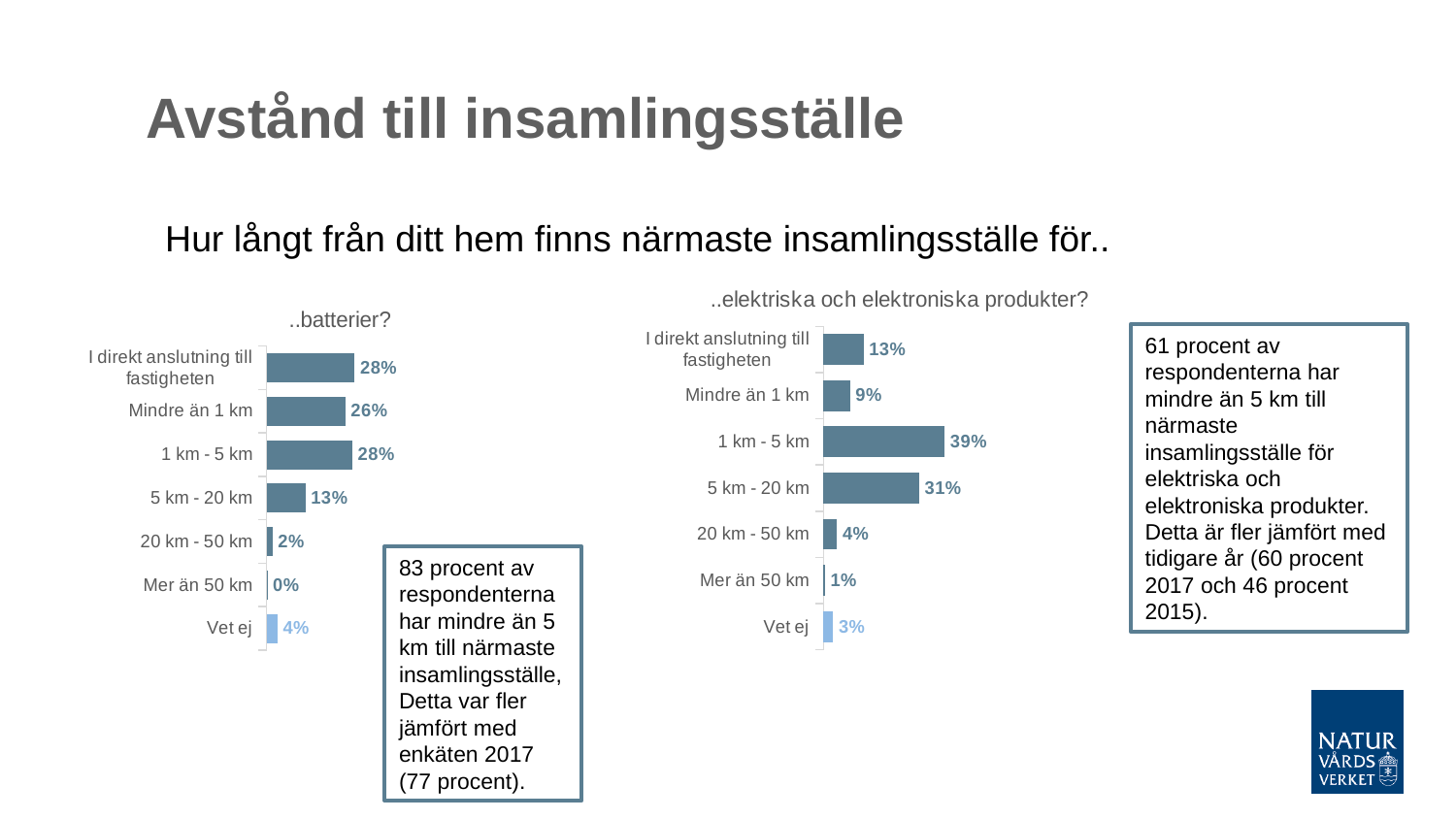
In the '..batterier?' chart, what is the value for 'Vet ej'? 4% In the '..batterier?' chart, what is the value for 'Mindre än 1 km'? 26% In the '..elektriska och elektroniska produkter?' chart, what is the value for '1 km - 5 km'? 39% In the '..batterier?' chart, what is the value for '5 km - 20 km'? 13% In the '..batterier?' chart, which is larger: 'Mindre än 1 km' or '5 km - 20 km'? Mindre än 1 km In the '..elektriska och elektroniska produkter?' chart, which category has the highest value? 1 km - 5 km In the '..elektriska och elektroniska produkter?' chart, what is the difference between '1 km - 5 km' and '5 km - 20 km'? 8% In the '..elektriska och elektroniska produkter?' chart, what is the value for 'I direkt anslutning till fastigheten'? 13% In the '..batterier?' chart, which category has the lowest value? Mer än 50 km What kind of chart is the '..elektriska och elektroniska produkter?' chart? Bar chart How many categories does the '..batterier?' chart show? 7 In the '..elektriska och elektroniska produkter?' chart, what is the value for 'Mer än 50 km'? 1%